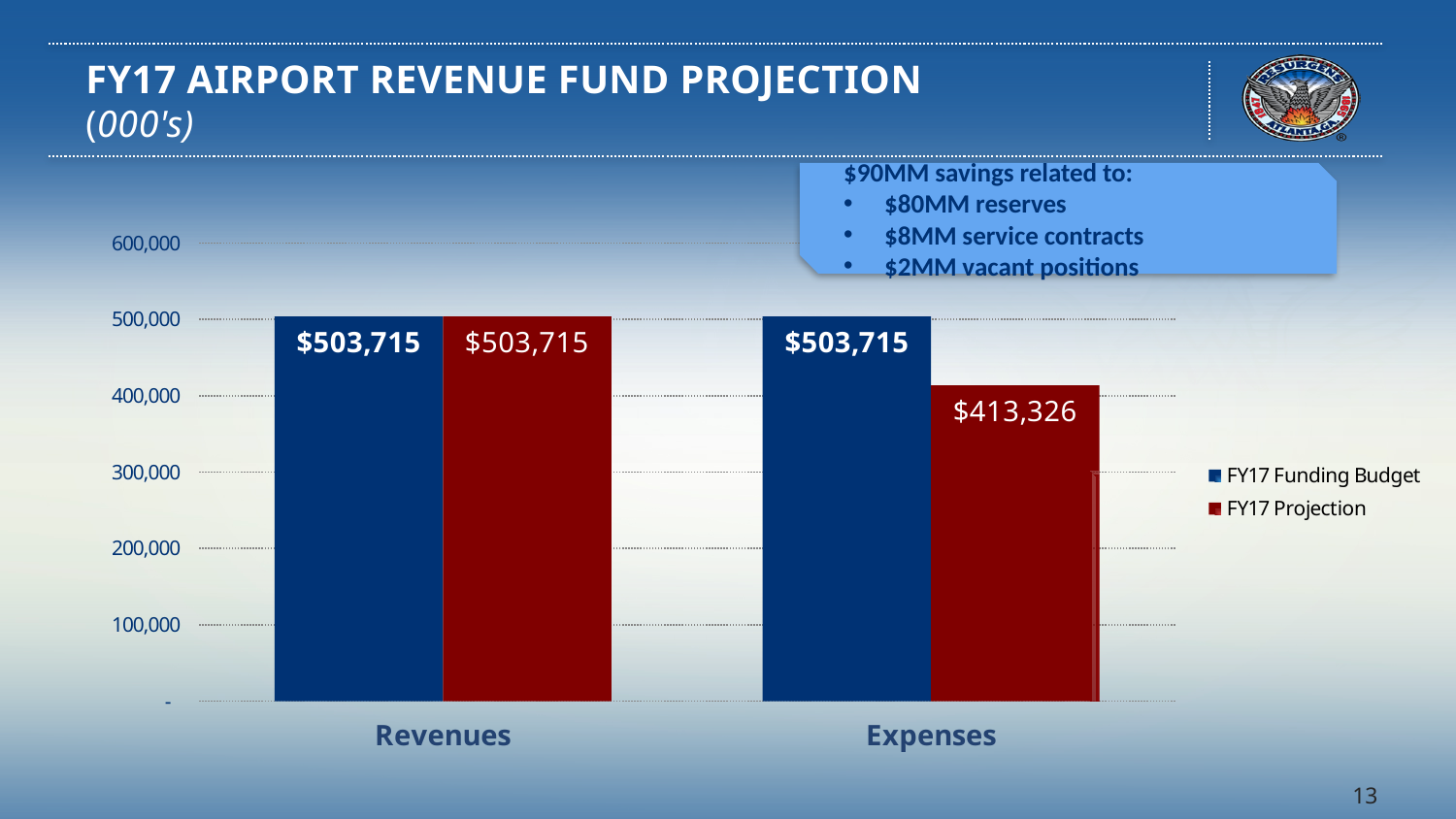
What kind of chart is shown on the slide? bar chart What is the difference between the FY17 Funding Budget and the FY17 Projection for Expenses? $90,389 Is the FY17 Projection value for Expenses greater or less than 500,000? less What is the FY17 Projection value for Revenues? $503,715 What is the FY17 Funding Budget value for Revenues? $503,715 Is the FY17 Funding Budget value for Revenues greater or less than 400,000? greater Which is larger for Expenses, the FY17 Funding Budget or the FY17 Projection? FY17 Funding Budget How many categories are shown on the x axis? 2 How many series does the legend list? 2 Which series is shown in red in the legend? FY17 Projection What is the FY17 Funding Budget value for Expenses? $503,715 What is the FY17 Projection value for Expenses? $413,326